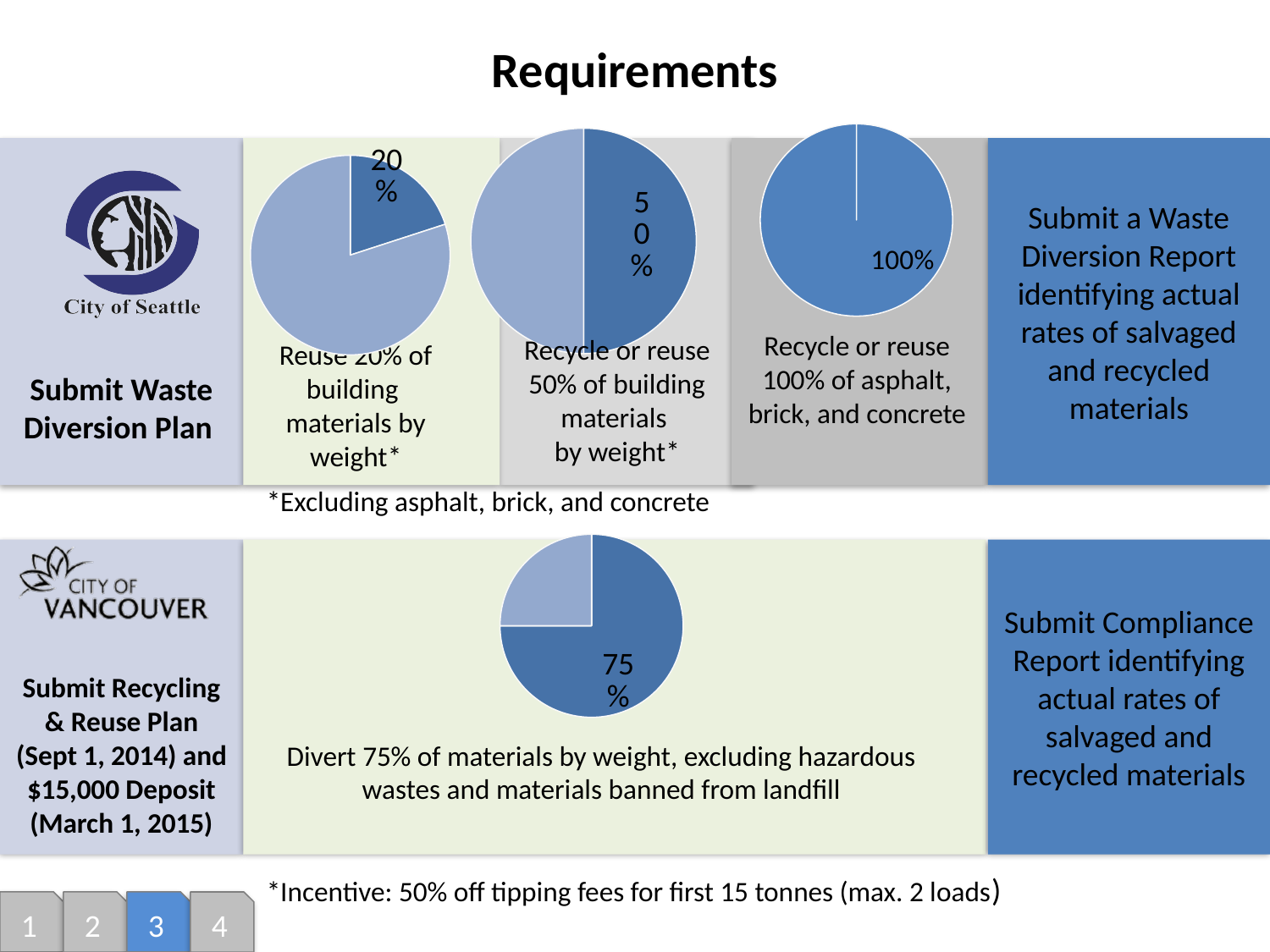
In the City of Vancouver pie chart, what share of the pie does the dark blue slice represent? 75% What kind of chart is used to show the 20% reuse requirement in the City of Seattle row? pie chart In the City of Vancouver pie chart above "Divert 75% of materials by weight", what value is labelled on the dark blue slice? 75% In the pie chart above "Recycle or reuse 100% of asphalt, brick, and concrete", what value is labelled on the pie? 100% What is the difference between the labelled share in the Vancouver diversion pie (75%) and the Seattle recycle-or-reuse building materials pie (50%)? 25 percentage points In the pie chart above "Recycle or reuse 50% of building materials by weight", what value is labelled on the dark blue slice? 50% In the pie chart above "Reuse 20% of building materials by weight", what value is labelled on the dark blue slice? 20% Which is larger: the labelled slice in the Seattle 20% reuse pie or the labelled slice in the Vancouver 75% diversion pie? The Vancouver 75% diversion pie What colour is the 75% slice in the City of Vancouver pie chart? dark blue How many pie charts are shown on the slide? 4 Which pie chart on the slide shows the largest labelled share? The pie for recycling or reusing 100% of asphalt, brick, and concrete Which pie chart on the slide shows the smallest labelled share? The pie for reusing 20% of building materials by weight